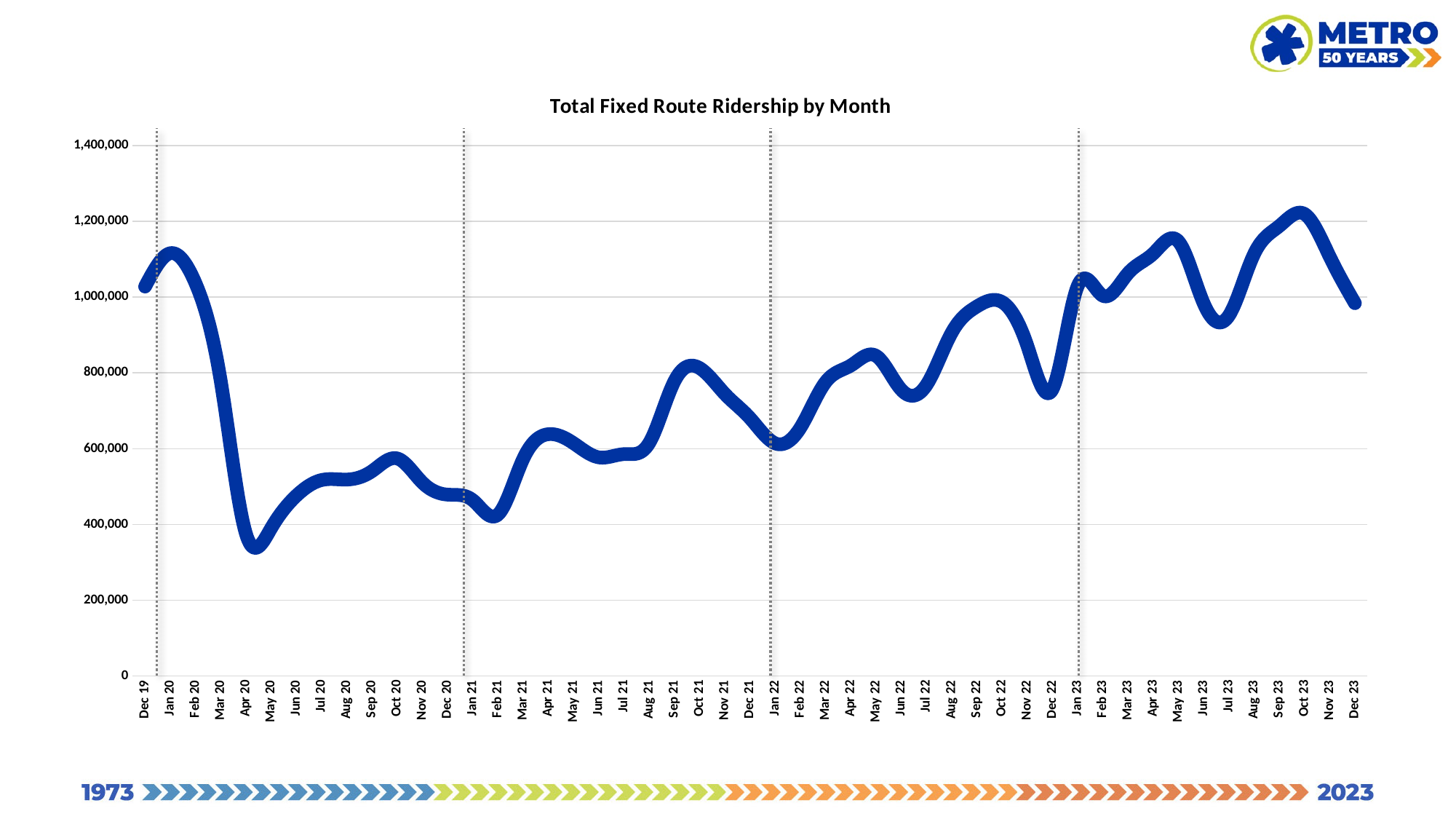
Do the values rise or fall from Jan 20 to Apr 20? fall Is the value for Dec 22 greater or less than 800,000? less What kind of chart is shown on the slide? line chart What is the title of the chart? Total Fixed Route Ridership by Month Which month has the highest ridership on the chart? Oct 23 Is the value for Oct 23 greater or less than 1,200,000? greater Which month has the lowest ridership on the chart? Apr 20 Which is larger, the value for Oct 21 or the value for Oct 22? Oct 22 Which is larger, the value for Jan 20 or the value for Jan 21? Jan 20 Is the value for May 23 greater or less than 1,000,000? greater How many monthly data points are plotted on the chart? 49